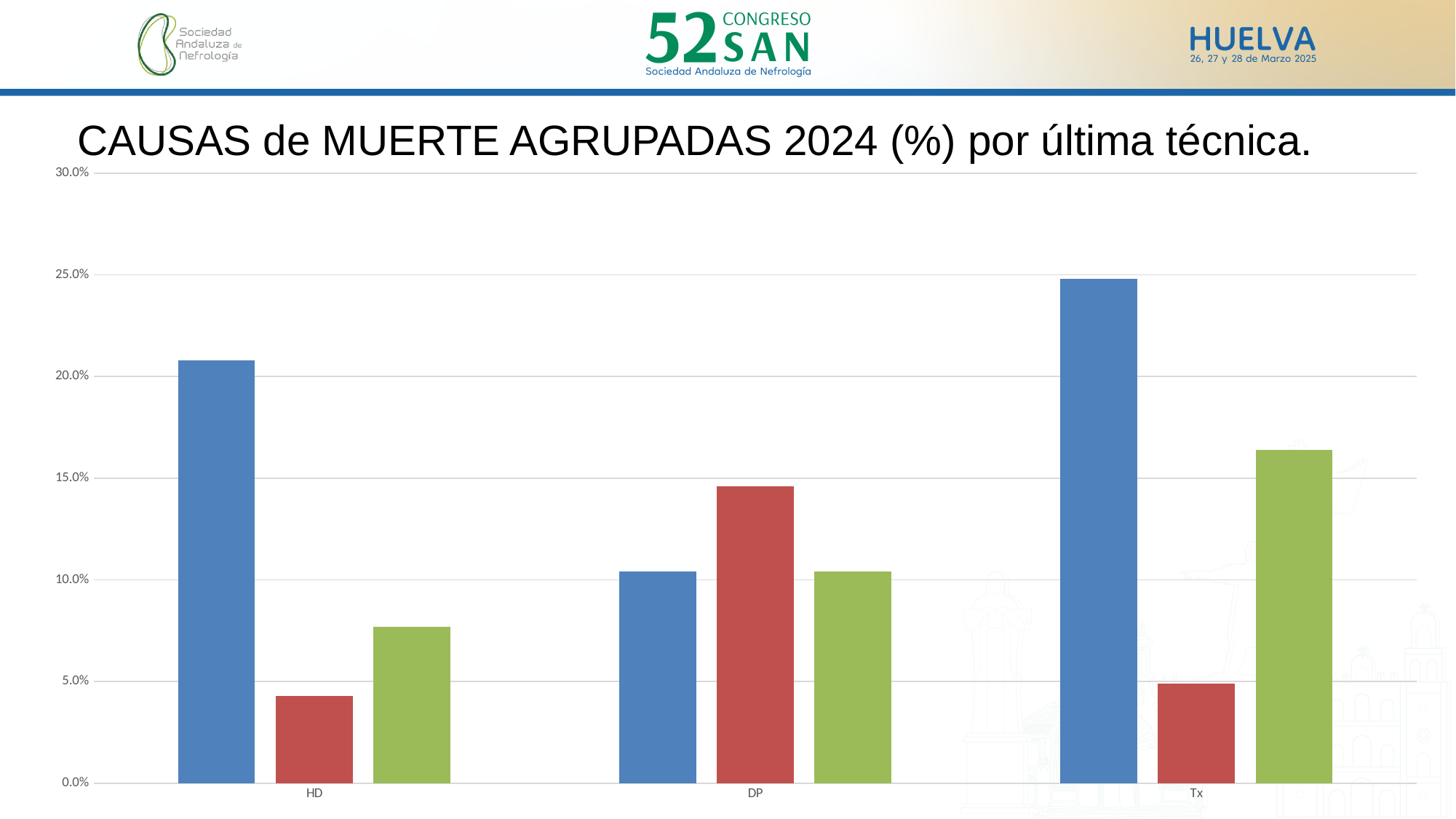
Is the value of the blue bar for HD greater or less than 25.0%? less Which is larger for DP, the blue bar or the red bar? the red bar How many categories are shown on the x axis of the chart? 3 Is the value of the red bar for HD greater or less than 5.0%? less Is the value of the green bar for Tx greater or less than 15.0%? greater What kind of chart is shown on the slide? bar chart Which category has the shortest green bar? HD Which category has the tallest blue bar? Tx What is the title of the chart? CAUSAS de MUERTE AGRUPADAS 2024 (%) por última técnica. What are the category labels on the x axis of the chart? HD, DP, Tx